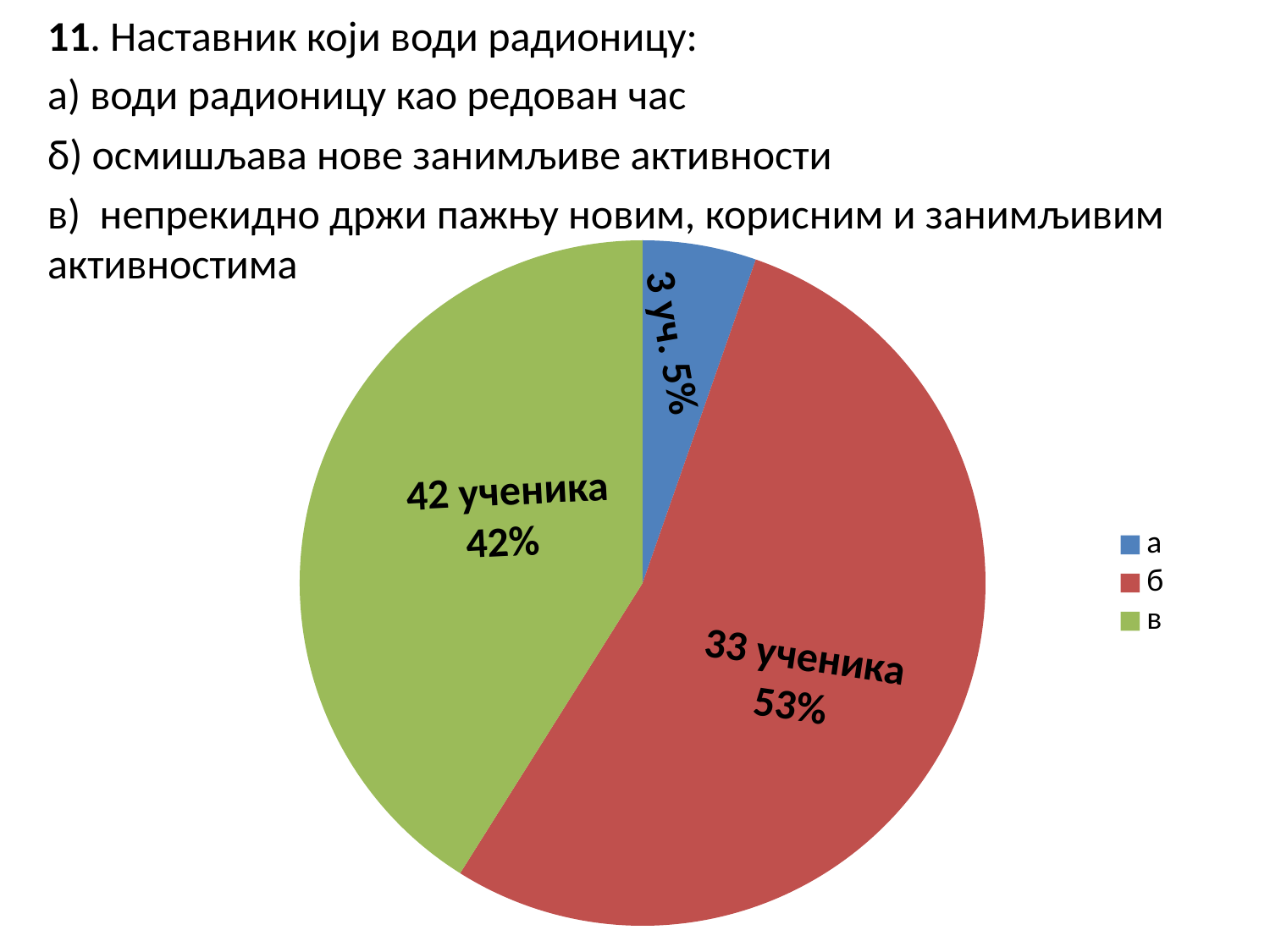
What is the data label printed on the green slice (в) of the pie chart? 42 ученика 42% What percentage share does slice а have in the pie chart? 5% How many entries does the legend of the pie chart list? 3 What percentage share does slice в have in the pie chart? 42% What is the data label printed on the blue slice (а) of the pie chart? 3 уч. 5% What is the data label printed on the red slice (б) of the pie chart? 33 ученика 53% What colour is slice в in the pie chart? green What percentage share does slice б have in the pie chart? 53% Which slice has the largest percentage share in the pie chart? б Which slice has the smallest percentage share in the pie chart? а How many slices does the pie chart have? 3 What kind of chart is shown on the slide? pie chart